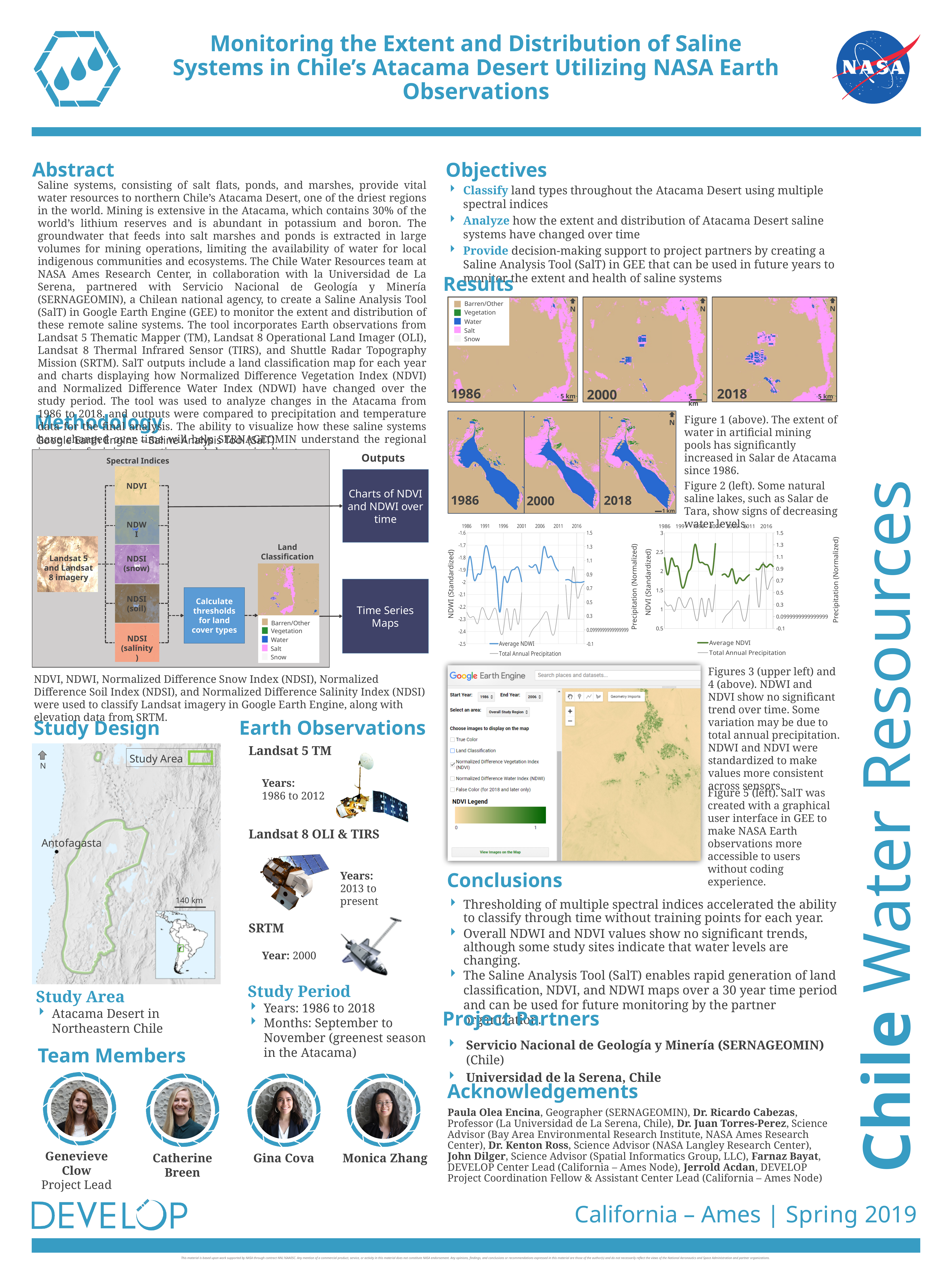
How many year ticks are shown on the x axis of the Average NDWI chart? 7 What is the highest tick value on the left vertical axis of the Average NDVI chart? 3 How many series does the legend of the Average NDWI chart list? 2 What is the last year tick shown on the x axis of the Average NDVI chart? 2016 How many series does the legend of the Average NDVI chart list? 2 What is the lowest tick value on the left vertical axis of the Average NDWI chart? -2.5 What is the first year shown on the x axis of the Average NDWI chart? 1986 What kind of chart is the chart with the legend entry 'Average NDWI'? line chart In the Average NDWI chart, what is the second series listed in the legend besides Average NDWI? Total Annual Precipitation What kind of chart is the chart with the legend entry 'Average NDVI'? line chart What is the label of the left vertical axis of the Average NDVI chart? NDVI (Standardized)